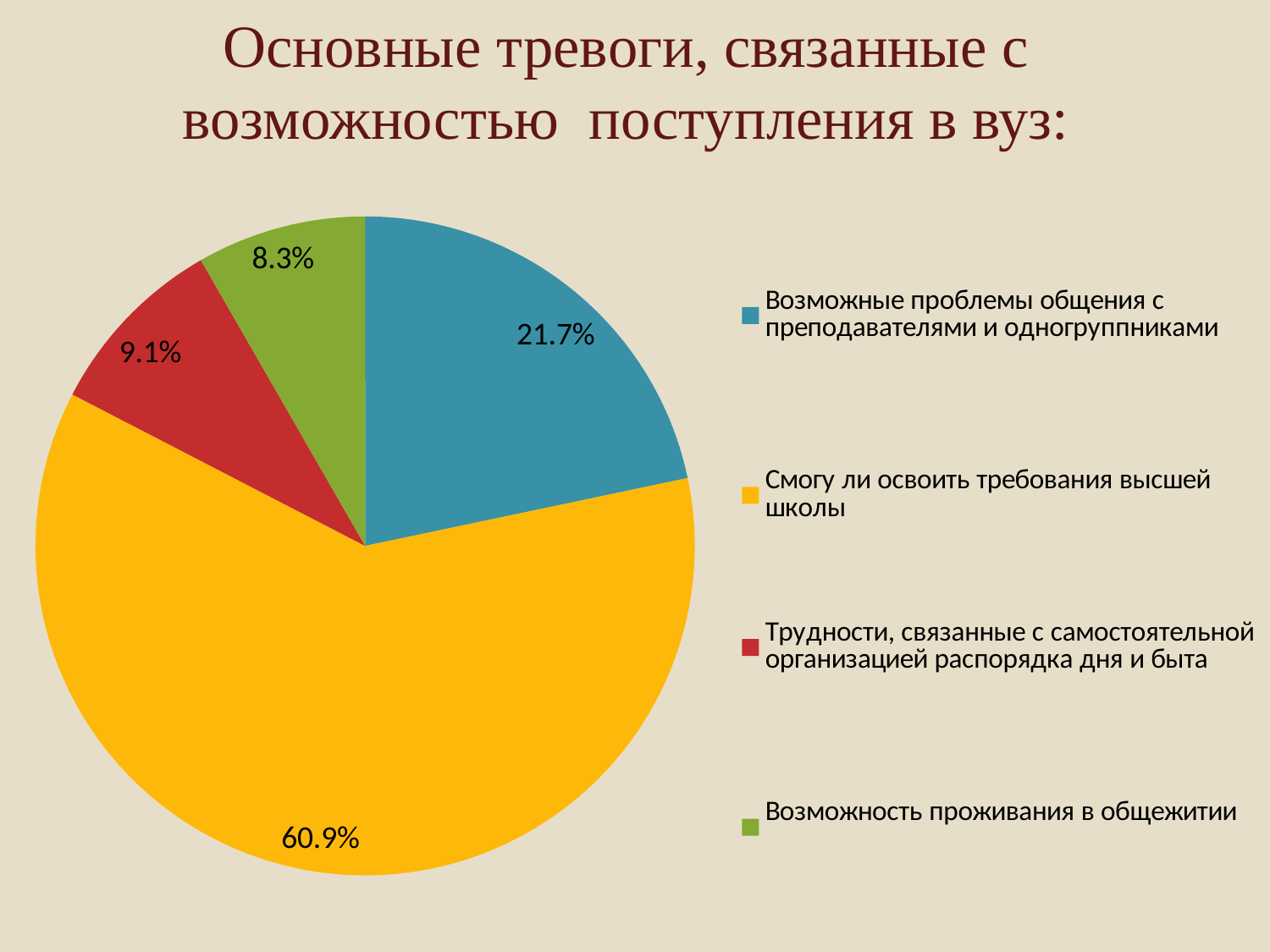
What share of the pie is labelled for "Смогу ли освоить требования высшей школы"? 60.9% What is the difference between the shares for "Смогу ли освоить требования высшей школы" and "Возможные проблемы общения с преподавателями и одногруппниками"? 39.2% Which category has the smallest slice of the pie? Возможность проживания в общежитии What type of chart is shown on the slide? pie chart What share of the pie is labelled for "Возможность проживания в общежитии"? 8.3% How many categories does the pie chart have? 4 What colour is the slice for "Возможность проживания в общежитии"? green What share of the pie is labelled for "Возможные проблемы общения с преподавателями и одногруппниками"? 21.7% Which is larger: the share for "Трудности, связанные с самостоятельной организацией распорядка дня и быта" or for "Возможность проживания в общежитии"? Трудности, связанные с самостоятельной организацией распорядка дня и быта What is the title of the slide? Основные тревоги, связанные с возможностью поступления в вуз: Which category has the largest slice of the pie? Смогу ли освоить требования высшей школы What share of the pie is labelled for "Трудности, связанные с самостоятельной организацией распорядка дня и быта"? 9.1%